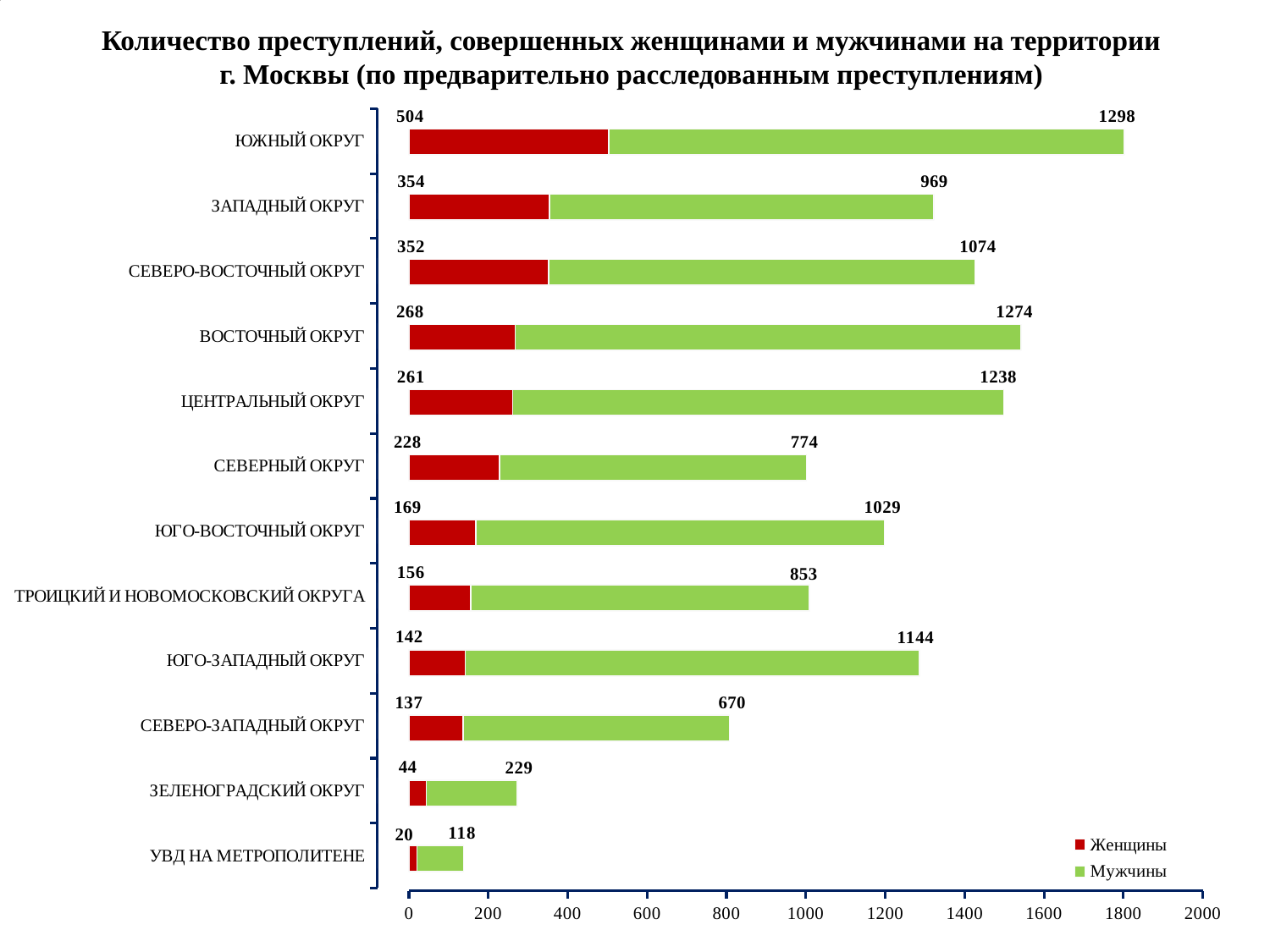
What is the total of the stacked bar for ЗЕЛЕНОГРАДСКИЙ ОКРУГ? 273 How many series does the legend list? 2 What is the value for Женщины in УВД НА МЕТРОПОЛИТЕНЕ? 20 Which colour represents Женщины in the legend? Red What is the difference between the Мужчины and Женщины values in ЮЖНЫЙ ОКРУГ? 794 What is the value for Мужчины in ЗЕЛЕНОГРАДСКИЙ ОКРУГ? 229 What is the value for Женщины in ЮЖНЫЙ ОКРУГ? 504 Which district has the highest value for Женщины? ЮЖНЫЙ ОКРУГ Which category has the lowest value for Мужчины? УВД НА МЕТРОПОЛИТЕНЕ Which has a larger Мужчины value: ЗАПАДНЫЙ ОКРУГ or СЕВЕРО-ВОСТОЧНЫЙ ОКРУГ? СЕВЕРО-ВОСТОЧНЫЙ ОКРУГ How many districts (categories) are shown on the chart? 12 What kind of chart is shown on the slide? Stacked bar chart